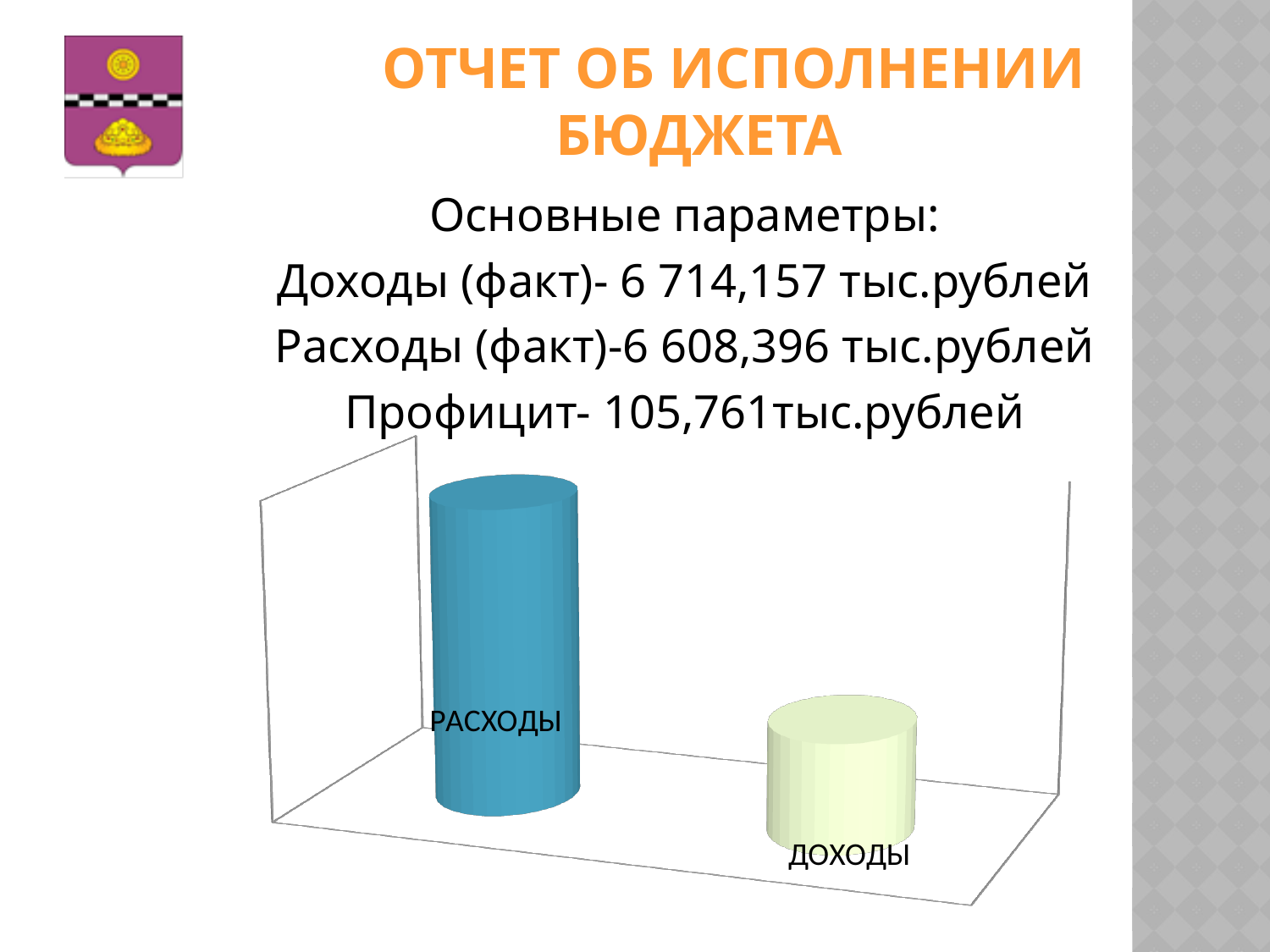
What is the label of the bar on the right side of the chart? ДОХОДЫ What kind of chart is shown on the slide? bar chart Which bar is taller in the chart, РАСХОДЫ or ДОХОДЫ? РАСХОДЫ What colour is the bar labelled РАСХОДЫ? blue Which category has the tallest bar in the chart? РАСХОДЫ Which category has the shortest bar in the chart? ДОХОДЫ How many bars are plotted in the chart? 2